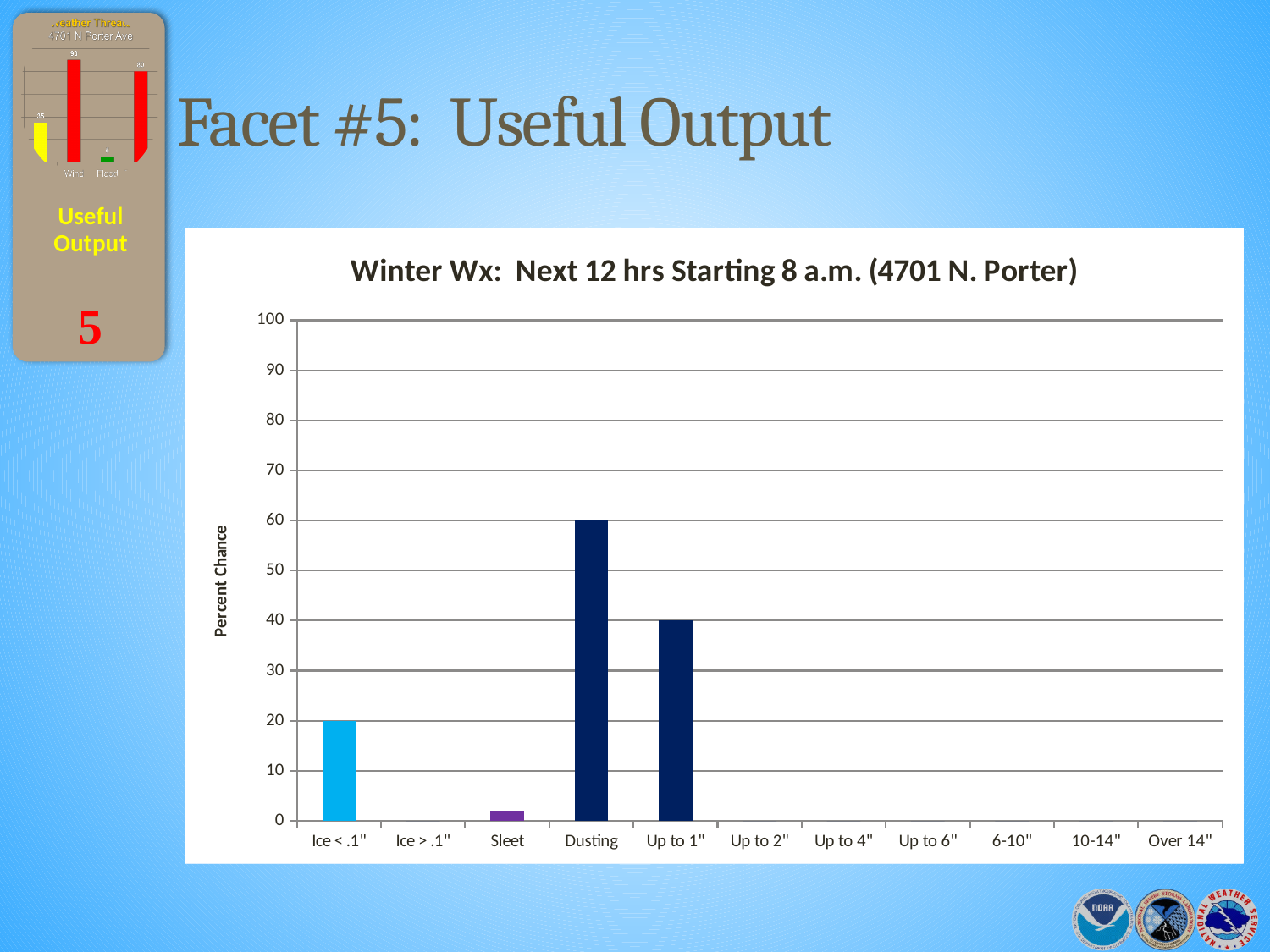
Which category has the highest percent chance? Dusting Which has a higher percent chance, Ice < .1" or Up to 1"? Up to 1" What is the difference in percent chance between Dusting and Up to 1"? 20 How many categories are shown on the x axis? 11 What is the percent chance for Dusting? 60 What is the percent chance for Up to 1"? 40 What is the label of the vertical axis? Percent Chance Is the value for Sleet greater or less than 10? less What kind of chart is shown on the slide? bar chart What is the percent chance for Ice < .1"? 20 Is the value for Dusting greater or less than 50? greater What is the difference in percent chance between Up to 1" and Ice < .1"? 20